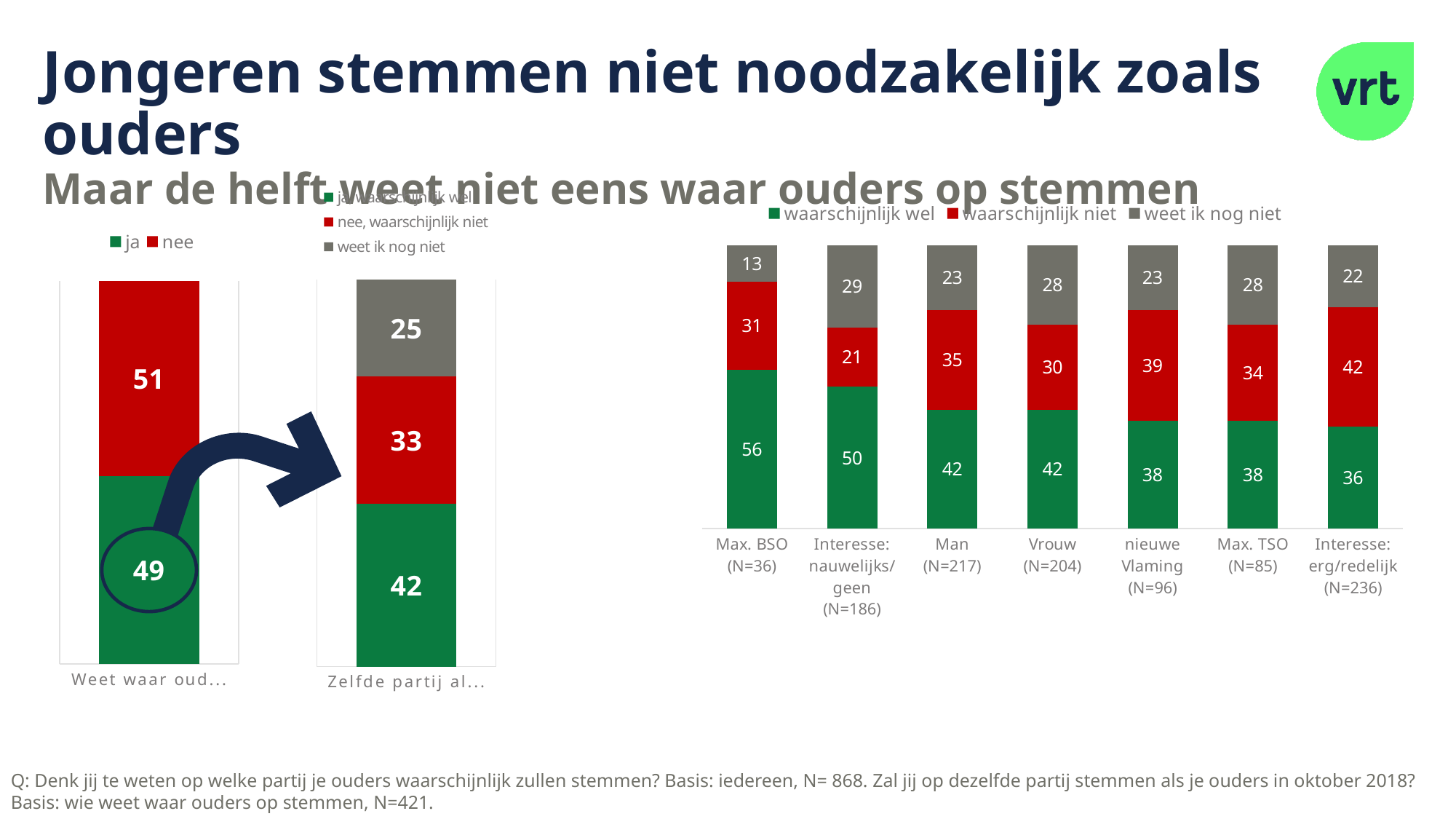
In the right-hand chart, what is the 'waarschijnlijk wel' value for 'Max. BSO (N=36)'? 56 In the middle chart labelled 'Zelfde partij al...', what is the total of the stacked bar? 100 In the middle chart labelled 'Zelfde partij al...', how many series does the legend list? 3 In the right-hand chart, what is the difference between the 'waarschijnlijk niet' values for 'nieuwe Vlaming (N=96)' and 'Interesse: nauwelijks/geen (N=186)'? 18 In the right-hand chart, which category has the lowest 'weet ik nog niet' value? Max. BSO (N=36) In the left chart labelled 'Weet waar oud...', what is the value for 'nee'? 51 In the right-hand chart, which category has the highest 'waarschijnlijk wel' value? Max. BSO (N=36) In the left chart labelled 'Weet waar oud...', which is larger, 'ja' or 'nee'? nee How many categories are shown on the x axis of the right-hand chart? 7 In the left chart labelled 'Weet waar oud...', what is the value for 'ja'? 49 In the right-hand chart, what is the 'waarschijnlijk niet' value for 'Interesse: erg/redelijk (N=236)'? 42 In the middle chart labelled 'Zelfde partij al...', what is the value for 'weet ik nog niet'? 25